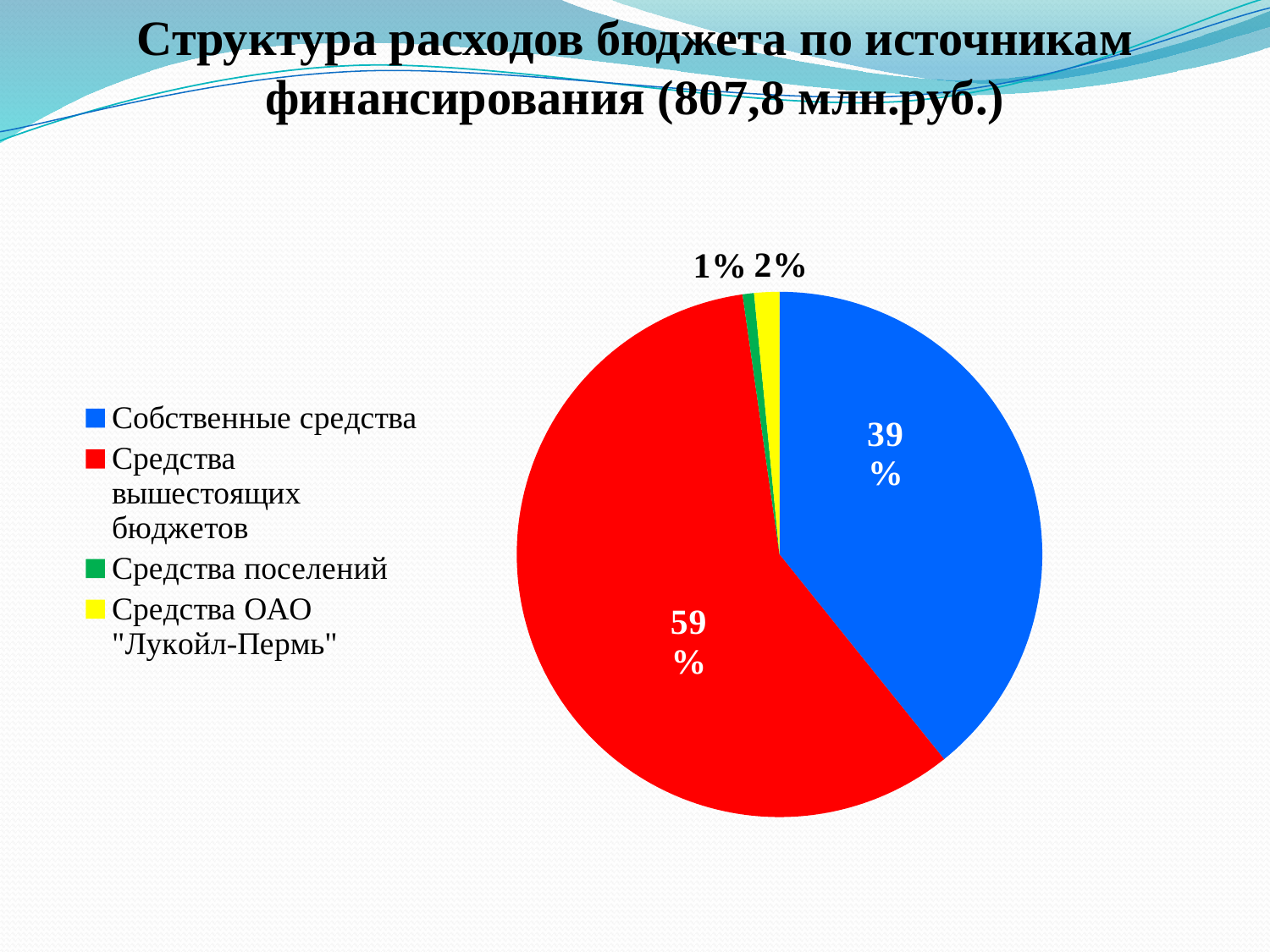
Which is larger: the share of "Собственные средства" or the share of "Средства вышестоящих бюджетов"? Средства вышестоящих бюджетов What share of the pie does "Средства поселений" have? 1% How many categories does the pie chart have? 4 What share of the pie does "Средства вышестоящих бюджетов" have? 59% Which category has the largest slice of the pie? Средства вышестоящих бюджетов What kind of chart is shown on the slide? Pie chart What colour is the slice for "Собственные средства"? Blue What total amount in million rubles is stated in the slide title? 807,8 млн.руб. What share of the pie does "Собственные средства" have? 39% What is the difference between the shares of "Средства вышестоящих бюджетов" and "Собственные средства"? 20% Which category has the smallest slice of the pie? Средства поселений